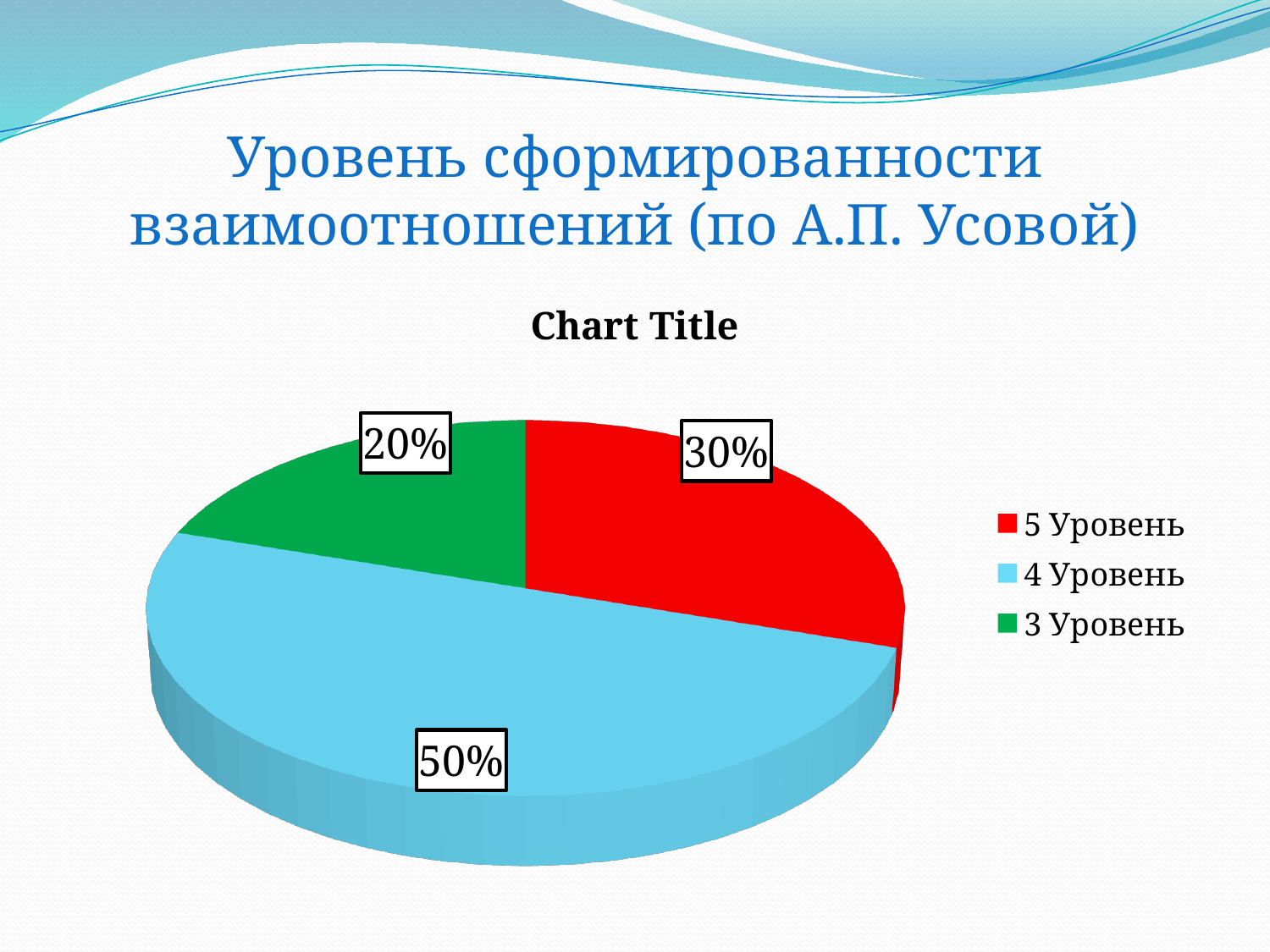
What is the difference in percentage points between 5 Уровень and 3 Уровень? 10% How many entries does the legend list? 3 What share of the pie does 4 Уровень have? 50% What share of the pie does 3 Уровень have? 20% Which level has the smallest slice of the pie? 3 Уровень What kind of chart is shown on the slide? pie chart What share of the pie does 5 Уровень have? 30% Which is larger, the slice for 5 Уровень or the slice for 3 Уровень? 5 Уровень What colour is the slice for 3 Уровень? green How many slices does the pie chart have? 3 What is the difference in percentage points between 4 Уровень and 5 Уровень? 20% Which level has the largest slice of the pie? 4 Уровень